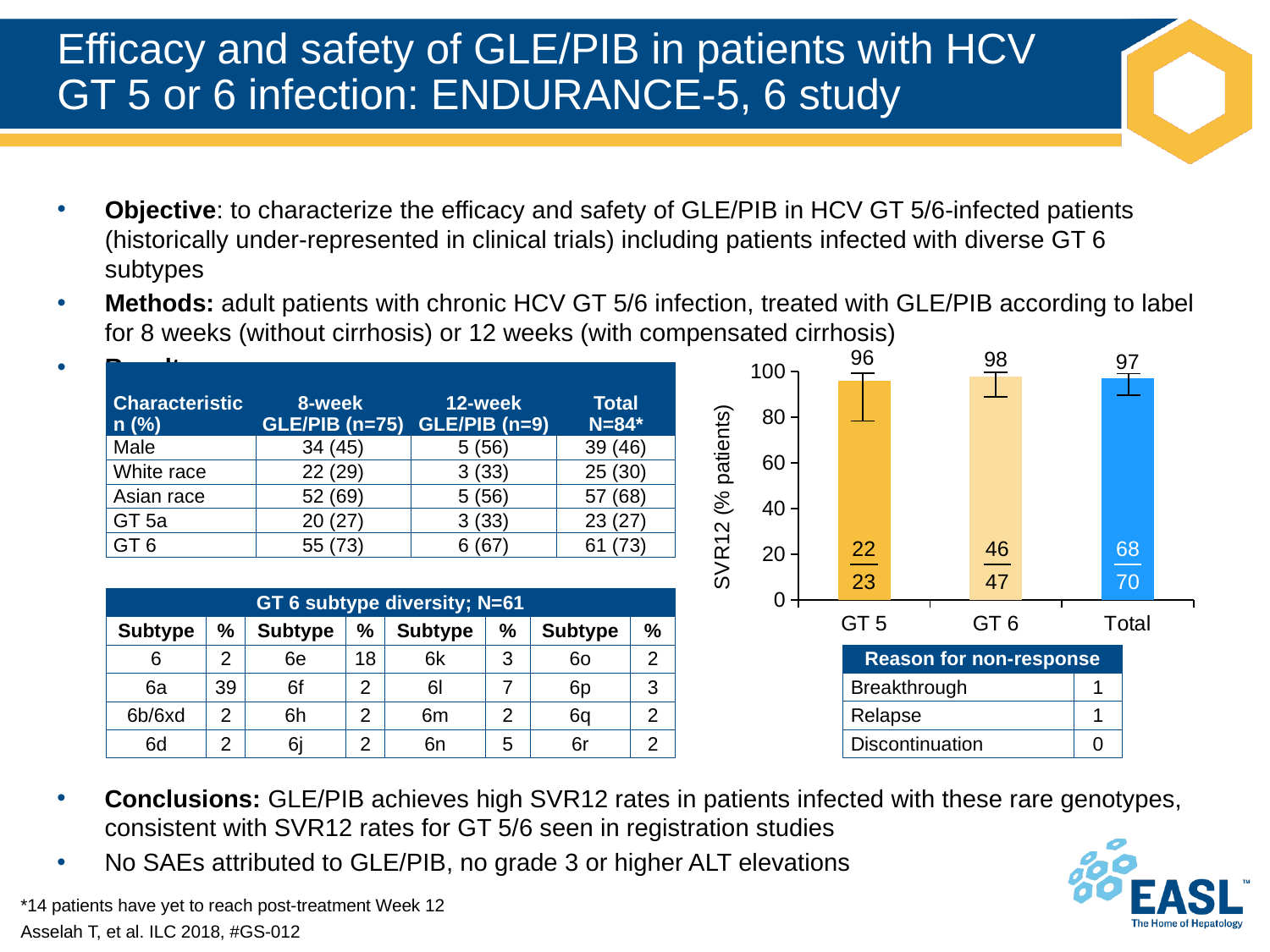
What is the difference between the SVR12 rates for GT 6 and GT 5 in the bar chart? 2 What kind of chart is used to show the SVR12 rates? Bar chart Is the SVR12 rate for GT 5 greater or less than 80? greater What is the SVR12 rate shown for GT 5 in the bar chart? 96 What is the SVR12 rate shown for GT 6 in the bar chart? 98 What is the label of the y axis of the bar chart? SVR12 (% patients) How many categories are shown on the x axis of the bar chart? 3 What fraction of patients is printed inside the GT 6 bar? 46/47 Which category has the highest SVR12 rate in the bar chart? GT 6 Which category has the lowest SVR12 rate in the bar chart? GT 5 What fraction of patients is printed inside the Total bar? 68/70 What is the SVR12 rate shown for the Total bar in the bar chart? 97